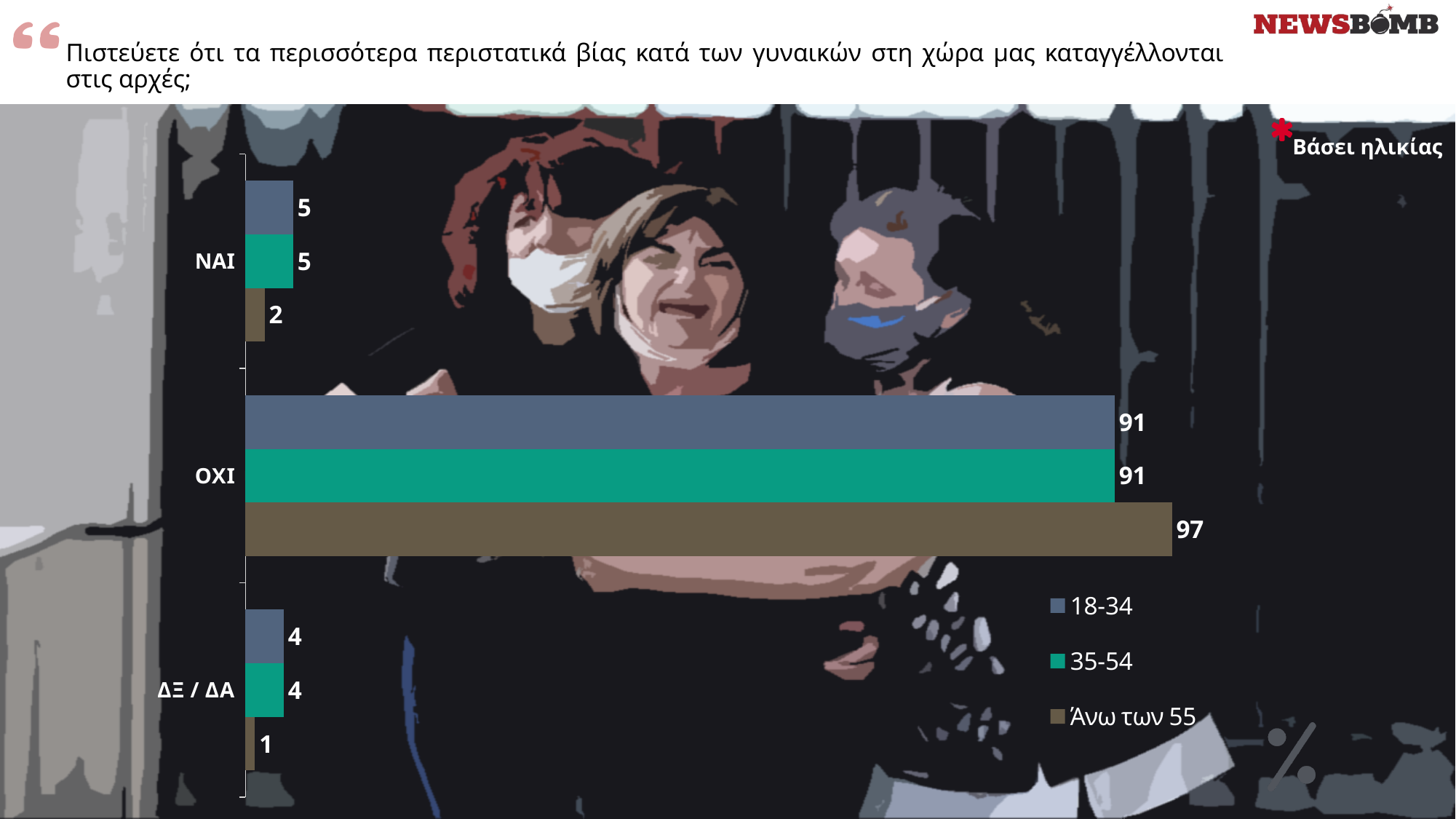
How many series does the legend list? 3 Which category has the highest value in the Άνω των 55 series? ΟΧΙ Which legend entry is shown in green? 35-54 For ΝΑΙ, which is larger: the 35-54 value or the Άνω των 55 value? 35-54 What is the value for ΟΧΙ in the 35-54 series? 91 How many categories are shown on the chart? 3 What is the difference between the Άνω των 55 and 18-34 values for ΟΧΙ? 6 What is the value for ΝΑΙ in the 18-34 series? 5 What is the value for ΔΞ / ΔΑ in the Άνω των 55 series? 1 What kind of chart is shown on the slide? bar chart What is the value for ΟΧΙ in the Άνω των 55 series? 97 Which category has the lowest value in the Άνω των 55 series? ΔΞ / ΔΑ